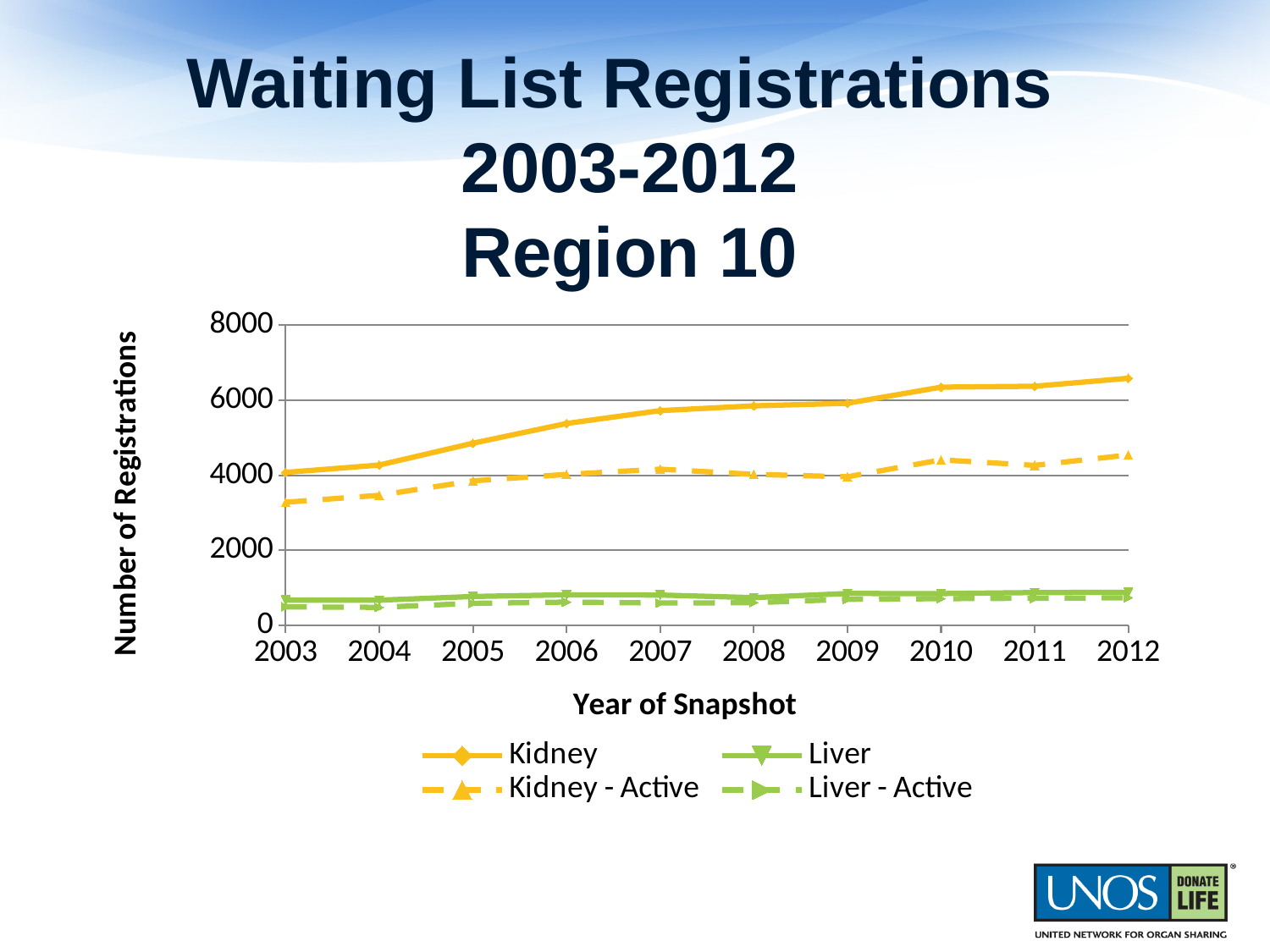
How many years are plotted along the x axis? 10 How many series does the legend list? 4 Does the Kidney series rise or fall from 2003 to 2012? rise Which series has the highest value in 2012? Kidney Is the value for Kidney - Active in 2003 greater or less than 4000? less Is the value for Liver in 2012 greater or less than 2000? less In which year is the Kidney series at its lowest? 2003 Is the value for Kidney in 2003 greater or less than 6000? less Which is larger in 2010, Kidney or Liver? Kidney What kind of chart is shown on the slide? line chart What is the label of the y axis? Number of Registrations